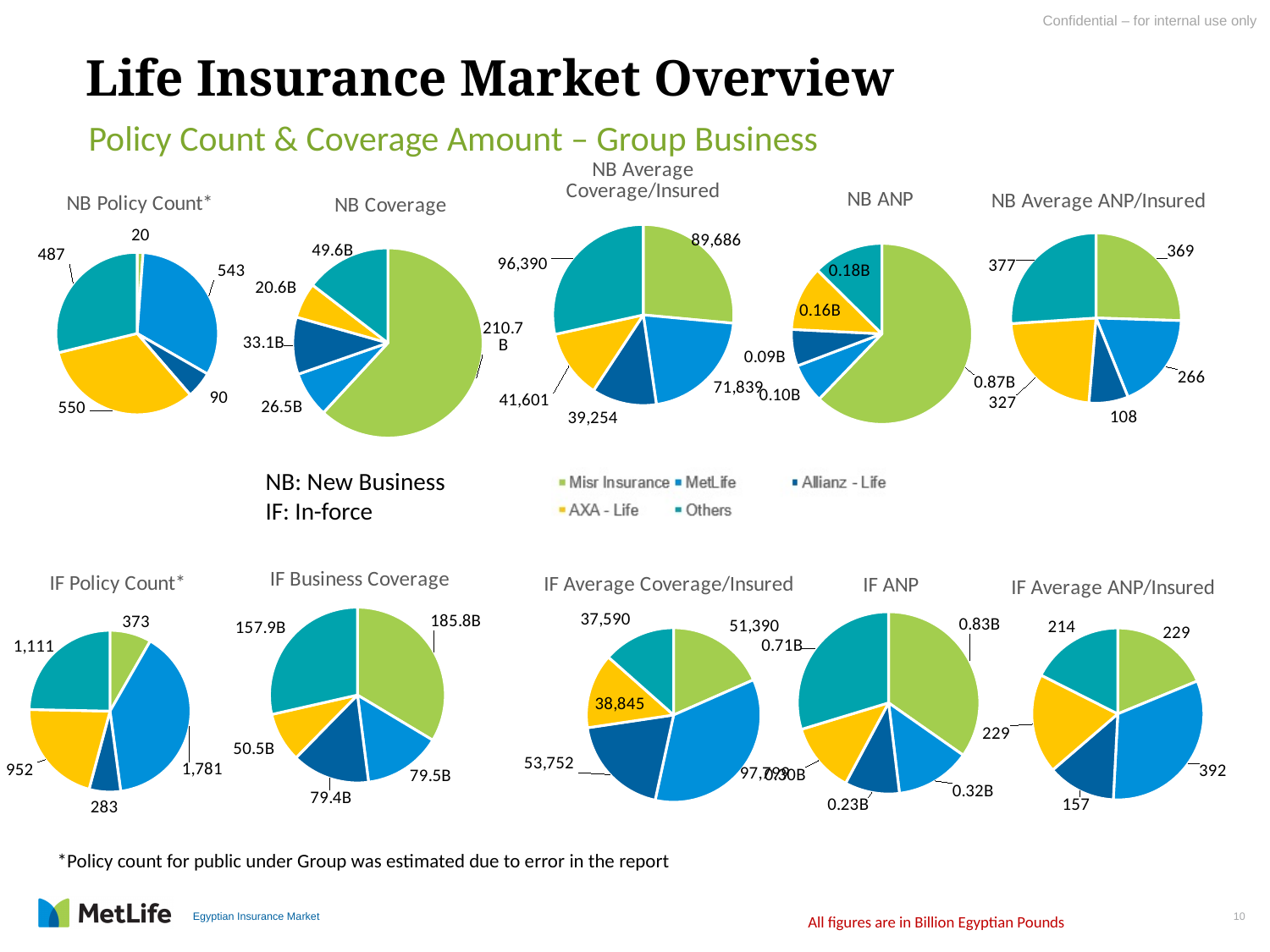
In the NB Coverage pie chart, what is the value for Misr Insurance? 210.7B How many entries does the shared legend list? 5 What type of chart is the NB Coverage chart? Pie chart In the NB ANP pie chart, what is the value for Others? 0.18B In the NB Policy Count pie chart, which company has the smallest slice? Misr Insurance In the IF Policy Count pie chart, which company has the largest slice? MetLife In the IF Average ANP/Insured pie chart, what is the value for MetLife? 392 In the IF ANP pie chart, which is larger: Misr Insurance or Others? Misr Insurance In the IF Business Coverage pie chart, what is the difference between the Misr Insurance value and the Others value? 27.9B In the IF Average Coverage/Insured pie chart, what is the value for MetLife? 97,799 How many slices does the NB Coverage pie chart have? 5 In the NB Average Coverage/Insured pie chart, which company has the highest value? Others